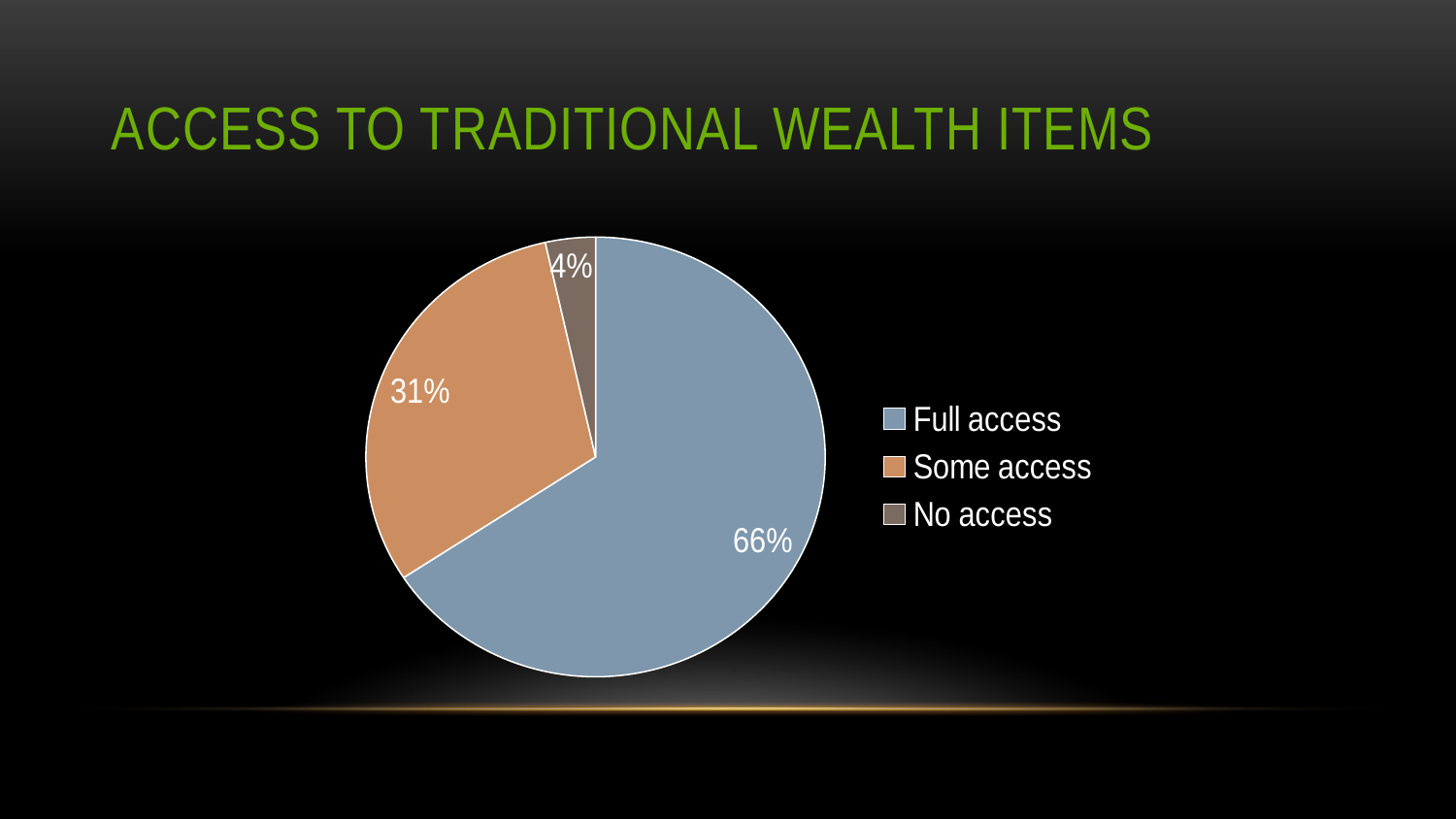
What is the difference in percentage points between Full access and Some access? 35 What is the difference in percentage points between Some access and No access? 27 What percentage of the pie is labelled Full access? 66% What percentage of the pie is labelled Some access? 31% Which is larger, the share for Some access or the share for No access? Some access Which category has the largest share of the pie? Full access What kind of chart is shown on the slide? pie chart How many categories does the pie chart have? 3 What is the title of the slide containing the chart? ACCESS TO TRADITIONAL WEALTH ITEMS Which category has the smallest share of the pie? No access Which legend entry is shown in orange? Some access What percentage of the pie is labelled No access? 4%